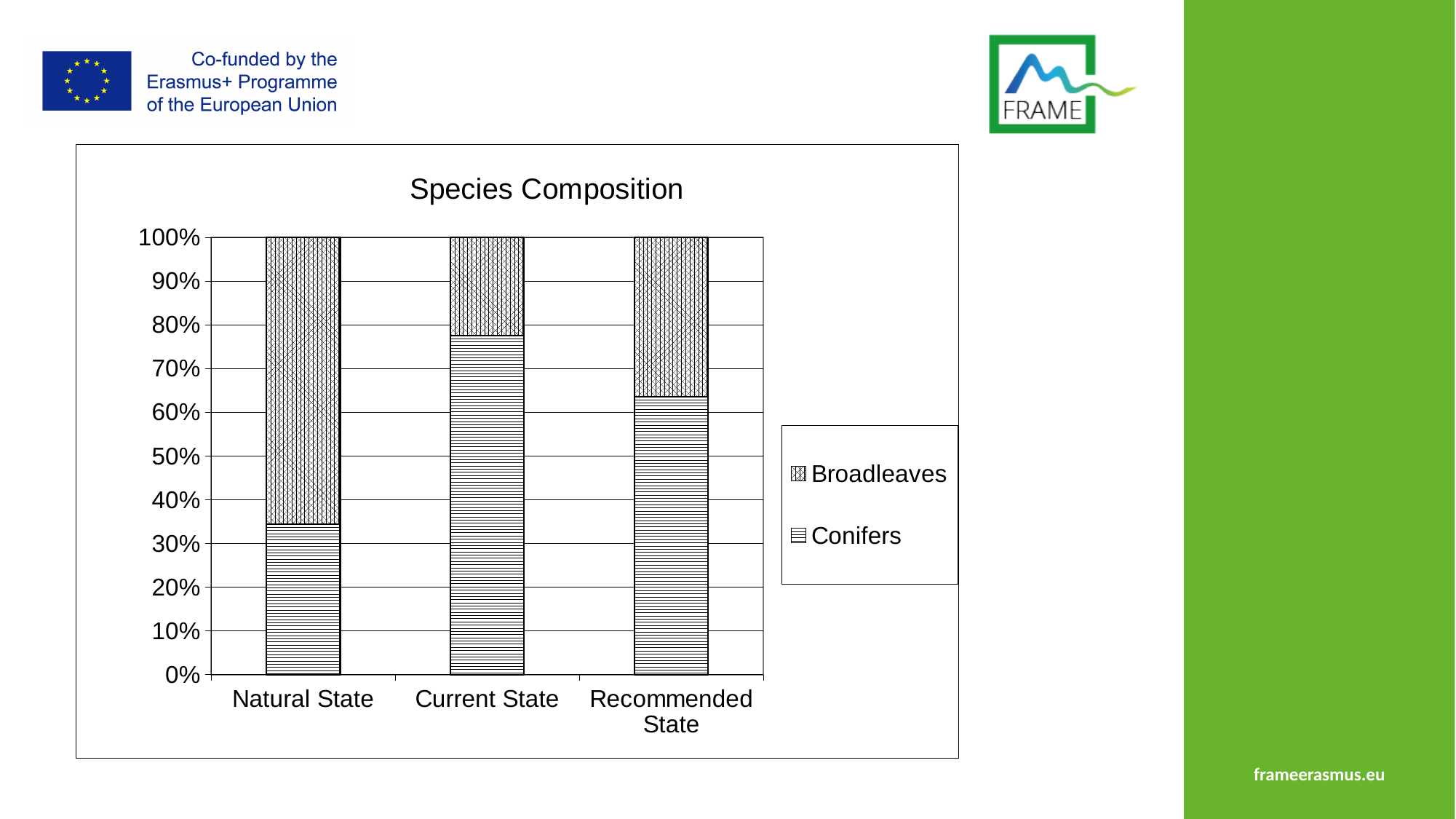
Is the Conifers share for Natural State greater or less than 40%? less Which category has the lowest Conifers share? Natural State What is the title of the chart? Species Composition Is the Conifers share for Current State greater or less than 70%? greater Which category has the highest Conifers share? Current State Which category has the largest Broadleaves share? Natural State Is the Broadleaves share larger for Current State or for Recommended State? Recommended State How many categories are shown on the x axis of the chart? 3 How many series does the legend list? 2 What kind of chart is shown on the slide? stacked bar chart Is the Conifers share for Recommended State greater or less than 60%? greater Which two series are listed in the chart legend? Broadleaves and Conifers